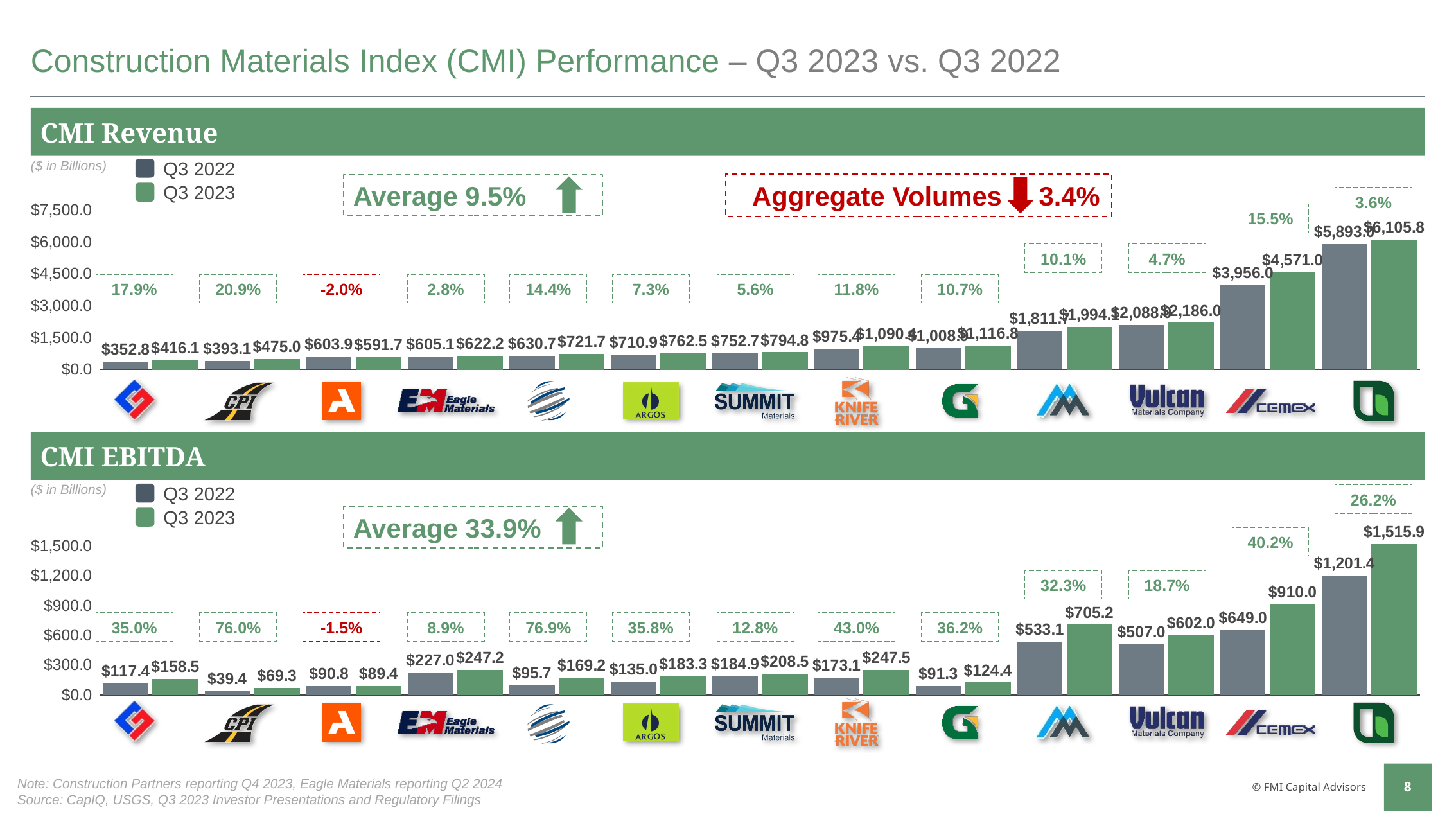
On the CMI EBITDA chart, what is the Q3 2023 EBITDA for Vulcan? $602.0 What type of chart is the CMI Revenue chart? bar chart How many series does the legend of the CMI EBITDA chart list? 2 On the CMI Revenue chart, what percentage change is shown for CPI? 20.9% On the CMI Revenue chart, what is the Q3 2022 revenue for Knife River? $975.4 On the CMI Revenue chart, which company has the larger Q3 2023 revenue, Vulcan or Cemex? Cemex On the CMI EBITDA chart, what is the difference between Cemex's Q3 2023 and Q3 2022 EBITDA? $261.0 On the CMI EBITDA chart, what is the lowest Q3 2022 EBITDA value shown? $39.4 On the CMI Revenue chart, what is the Q3 2023 revenue for Cemex? $4,571.0 What average percentage change is shown on the CMI EBITDA chart? 33.9% On the CMI Revenue chart, what is the highest Q3 2023 revenue value shown? $6,105.8 On the CMI Revenue chart, is the Q3 2023 revenue for Knife River greater or less than $1,500.0? less